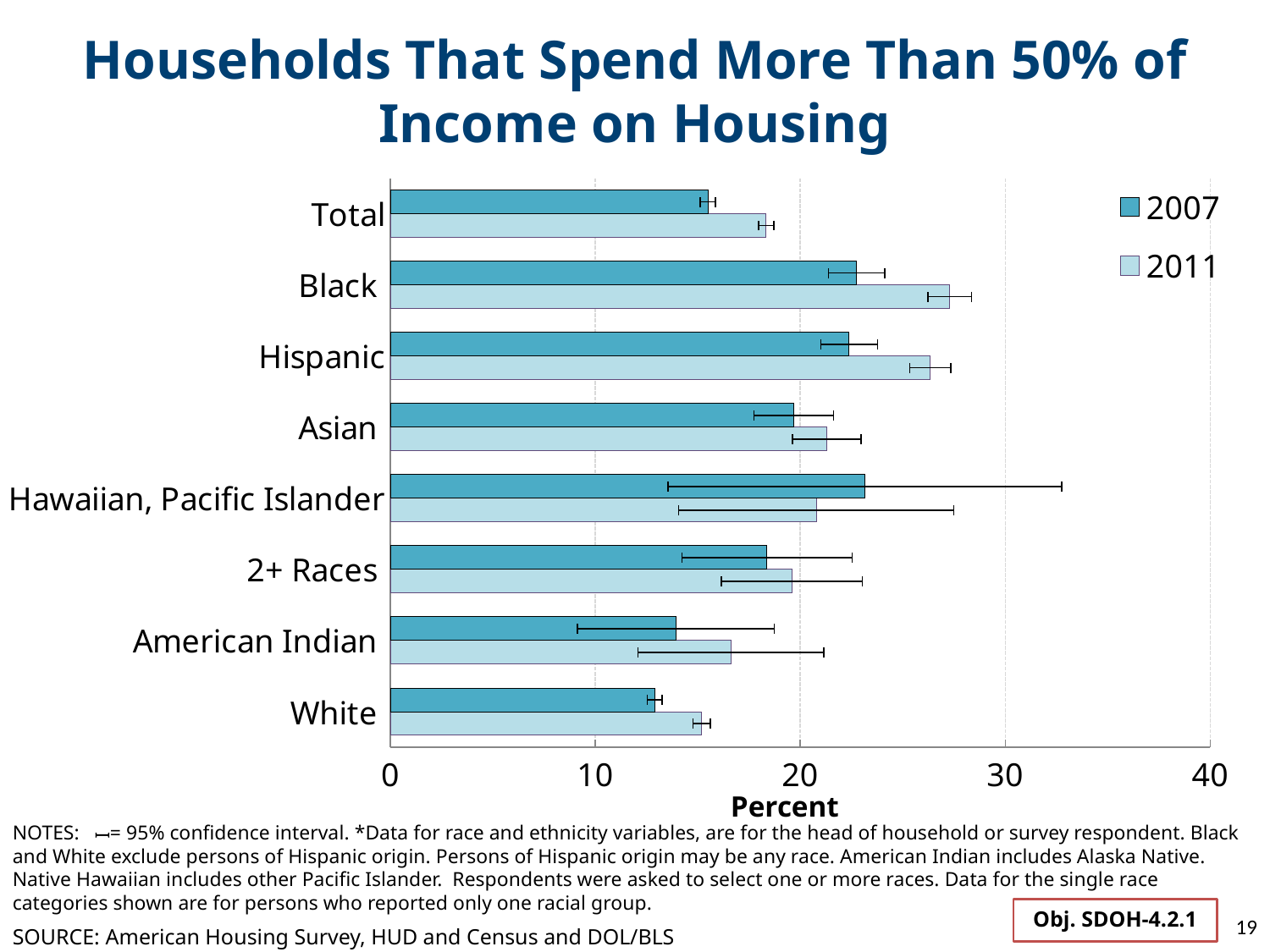
How many series does the legend list? 2 Is the 2011 value for American Indian greater or less than 10? greater For Hawaiian, Pacific Islander, which year has the larger value, 2007 or 2011? 2007 Is the 2007 value for White greater or less than 20? less Is the 2007 value for Total greater or less than 20? less How many categories are shown on the chart? 8 Which has the larger 2011 value, Black or White? Black What kind of chart is shown on the slide? bar chart For Black, which year has the larger value, 2007 or 2011? 2011 What is the label on the x axis? Percent